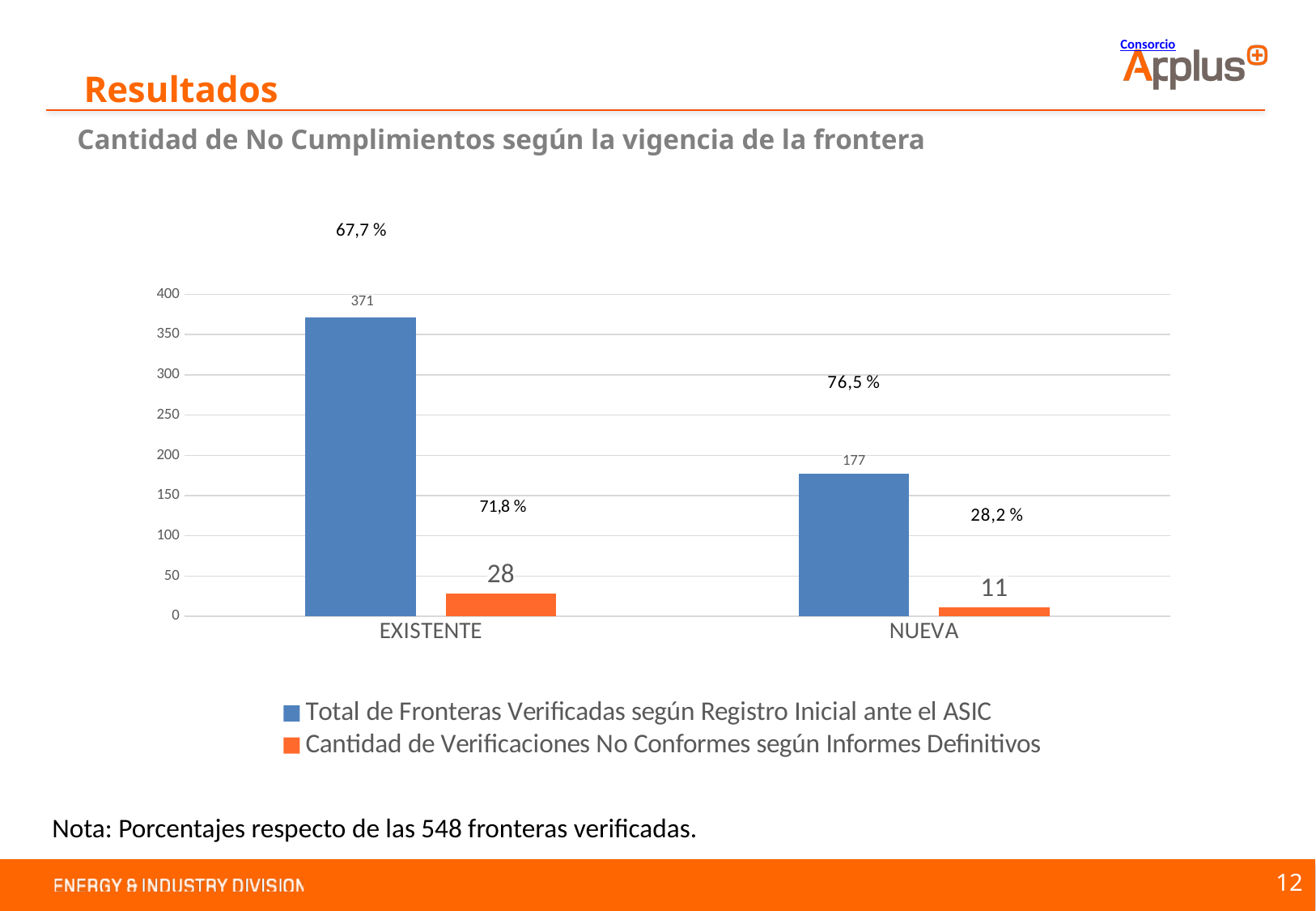
How many series does the legend list? 2 Is the Total de Fronteras Verificadas value for NUEVA greater or less than 200? less What is the difference between the Cantidad de Verificaciones No Conformes values for EXISTENTE and NUEVA? 17 What is the value of Cantidad de Verificaciones No Conformes según Informes Definitivos for NUEVA? 11 What is the difference between the Total de Fronteras Verificadas values for EXISTENTE and NUEVA? 194 What kind of chart is shown on the slide? Bar chart Which category has the higher value for Total de Fronteras Verificadas según Registro Inicial ante el ASIC? EXISTENTE What is the value of Cantidad de Verificaciones No Conformes según Informes Definitivos for EXISTENTE? 28 What is the value of Total de Fronteras Verificadas según Registro Inicial ante el ASIC for EXISTENTE? 371 How many categories are shown on the x axis? 2 What is the value of Total de Fronteras Verificadas según Registro Inicial ante el ASIC for NUEVA? 177 Which category has the lower value for Cantidad de Verificaciones No Conformes según Informes Definitivos? NUEVA